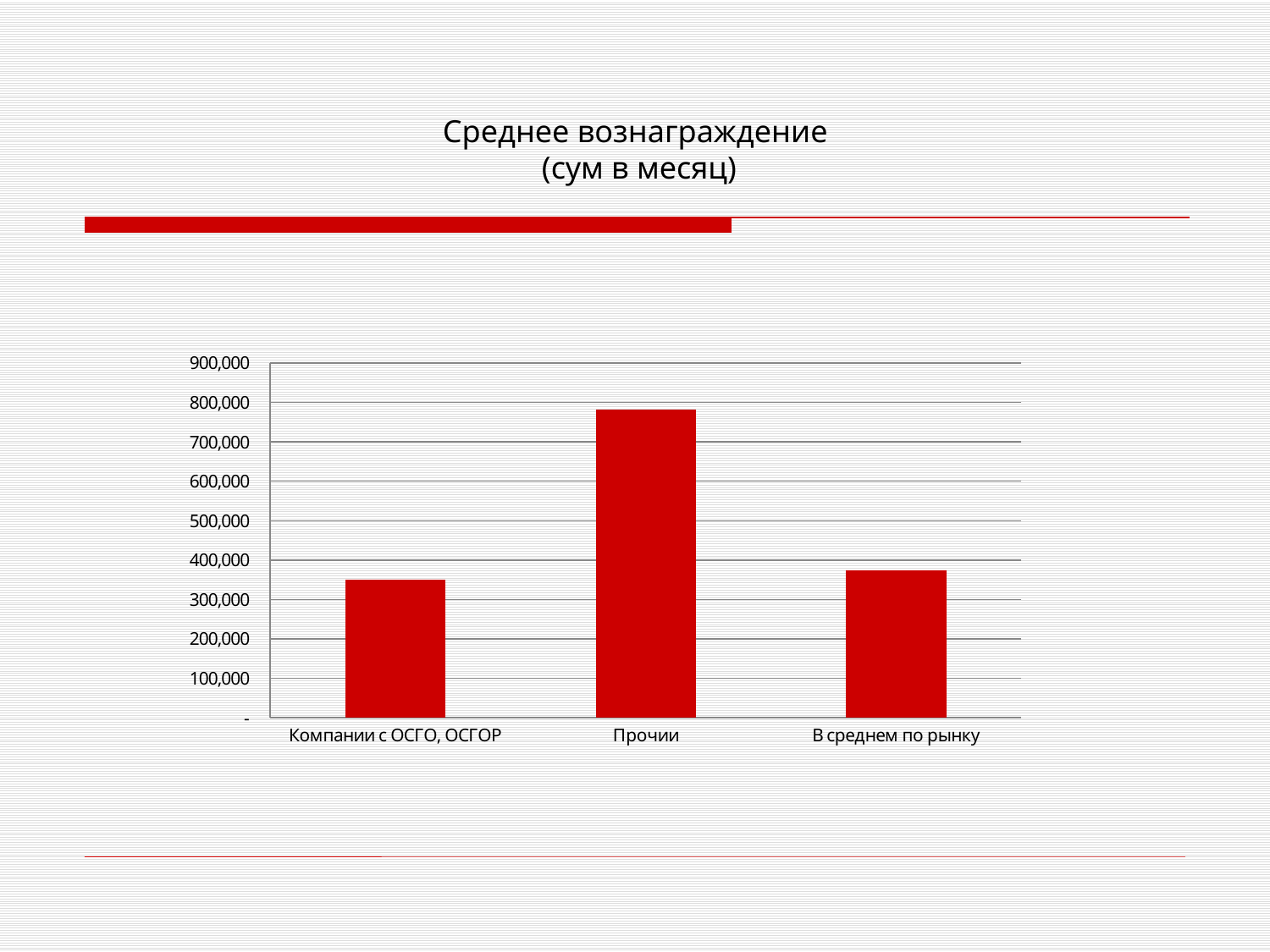
Which is larger, the value for Прочии or the value for В среднем по рынку? Прочии Is the value for Компании с ОСГО, ОСГОР greater or less than 300,000? greater Is the value for Прочии greater or less than 700,000? greater What is the title of the slide containing the chart? Среднее вознаграждение (сум в месяц) Is the value for Прочии greater or less than 800,000? less Which is larger, the value for Компании с ОСГО, ОСГОР or the value for Прочии? Прочии What kind of chart is shown on the slide? bar chart Which category has the highest value in the chart? Прочии How many categories are shown on the x axis of the chart? 3